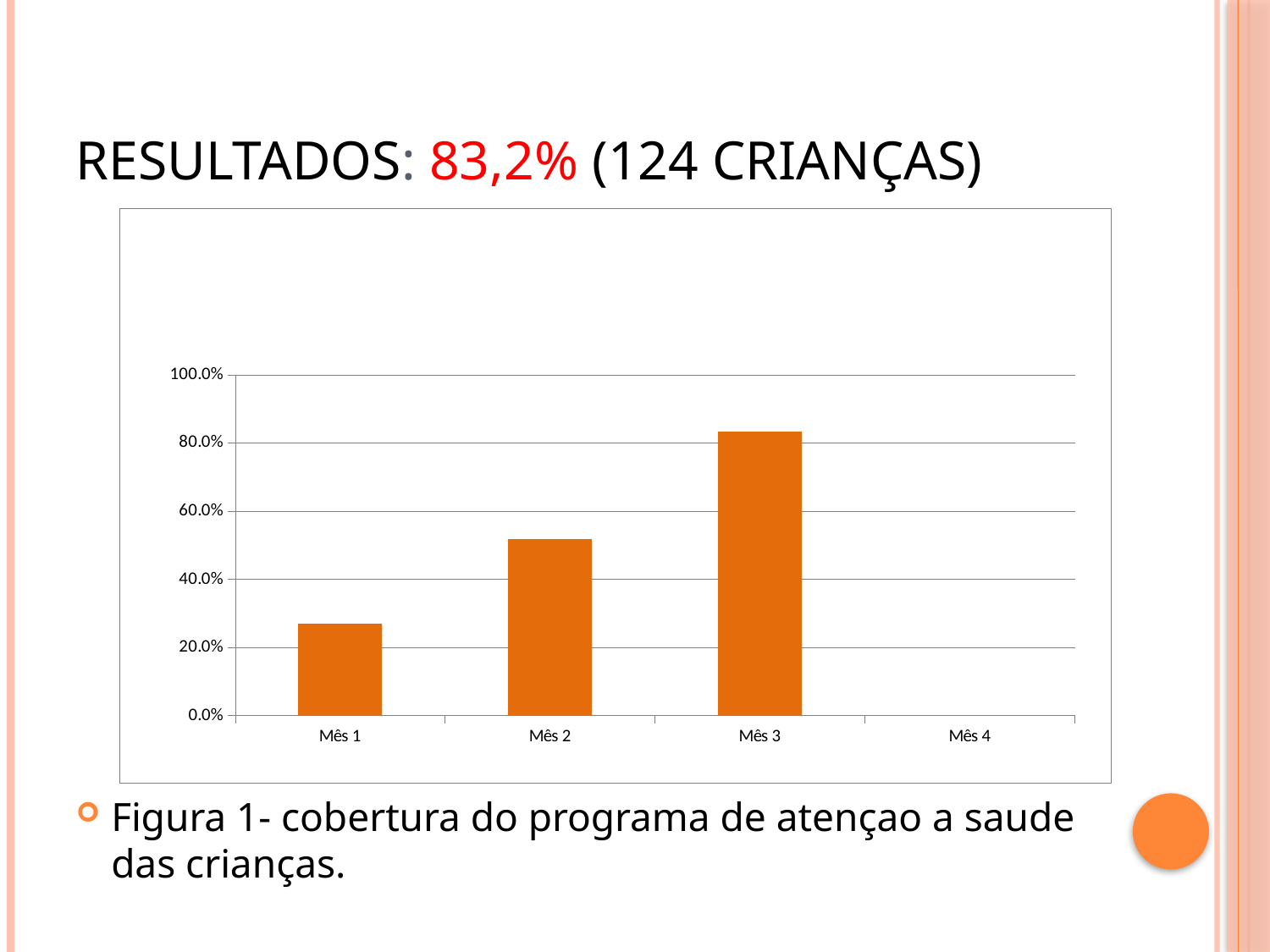
How many categories are shown on the x axis of the chart? 4 What kind of chart is shown on the slide? bar chart Is the value for Mês 2 greater or less than 40.0%? greater Which is larger, the value for Mês 2 or the value for Mês 1? Mês 2 Is the value for Mês 2 greater or less than 60.0%? less Is the value for Mês 3 greater or less than 60.0%? greater Among Mês 1, Mês 2 and Mês 3, which month has the lowest value? Mês 1 Do the values rise or fall from Mês 1 to Mês 3? rise Which month has the highest value in the chart? Mês 3 What is the highest tick value shown on the y axis of the chart? 100.0%